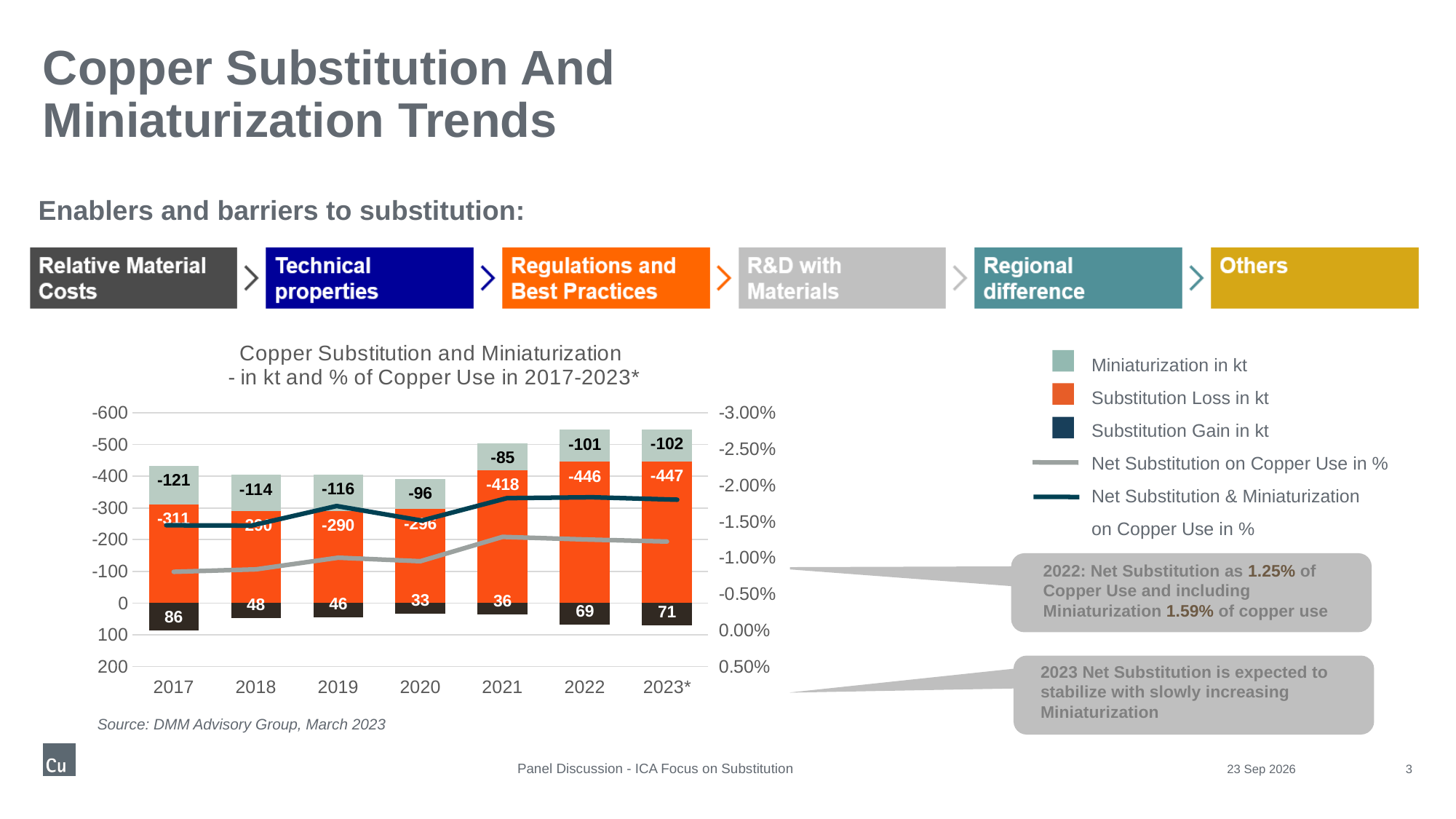
Which year has the highest Substitution Gain in kt? 2017 What is the Miniaturization in kt value for 2017? -121 Which year has the Miniaturization in kt label closest to zero? 2021 Does the magnitude of Substitution Loss in kt rise or fall from 2020 to 2022? rises How many years are shown on the x axis of the chart? 7 What is the Substitution Loss in kt value for 2022? -446 By how much does the Substitution Loss in kt label for 2023* differ from that for 2021? 29 By how much does the Miniaturization in kt label for 2017 differ from that for 2020? 25 How many series does the chart legend list? 5 What kind of chart is used to show the kt values? bar chart Which year has the larger Substitution Gain in kt, 2022 or 2023*? 2023* What is the Substitution Gain in kt value for 2020? 33